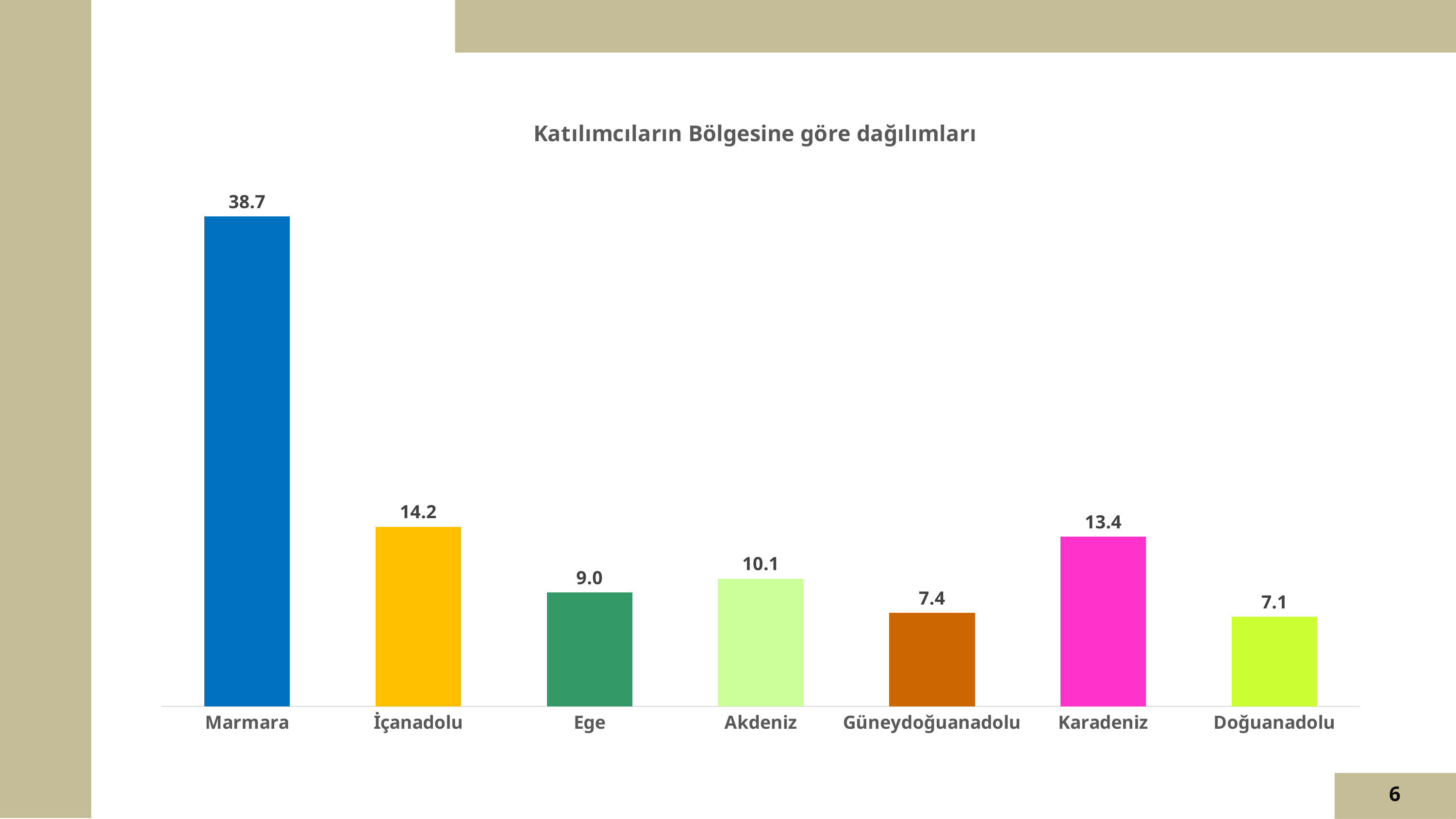
Which is larger, the value for Ege or the value for Akdeniz? Akdeniz Which region has the lowest value? Doğuanadolu What is the value for Güneydoğuanadolu? 7.4 How many regions are shown in the chart? 7 What kind of chart is shown on the slide? Bar chart Which is larger, the value for İçanadolu or the value for Karadeniz? İçanadolu What is the value for Marmara? 38.7 What is the difference between the values for Akdeniz and Ege? 1.1 Which region has the highest value? Marmara What is the value for Karadeniz? 13.4 What is the title of the chart? Katılımcıların Bölgesine göre dağılımları What is the difference between the values for Marmara and İçanadolu? 24.5